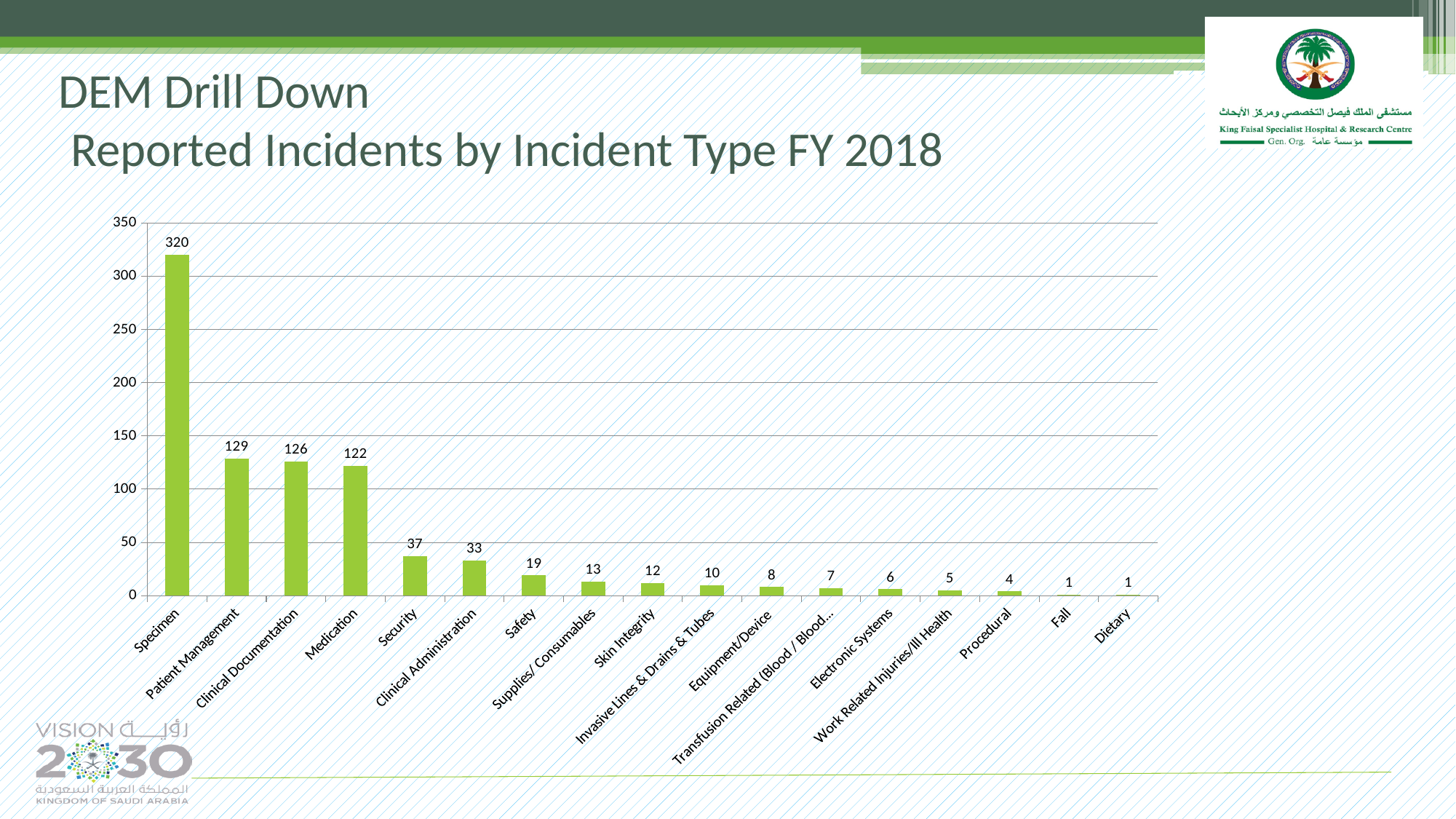
Which has more reported incidents, Clinical Documentation or Medication? Clinical Documentation What is the difference between the reported incidents for Specimen and Patient Management? 191 What is the number of reported incidents for Security? 37 How many incident type categories are shown on the x axis? 17 What is the number of reported incidents for Specimen? 320 Which incident type has the highest number of reported incidents? Specimen What is the difference between the reported incidents for Security and Clinical Administration? 4 What is the number of reported incidents for Medication? 122 What is the number of reported incidents for Electronic Systems? 6 What kind of chart is shown on the slide? Bar chart What is the title of the chart on the slide? DEM Drill Down Reported Incidents by Incident Type FY 2018 Do the values rise or fall moving from left to right along the x axis? Fall